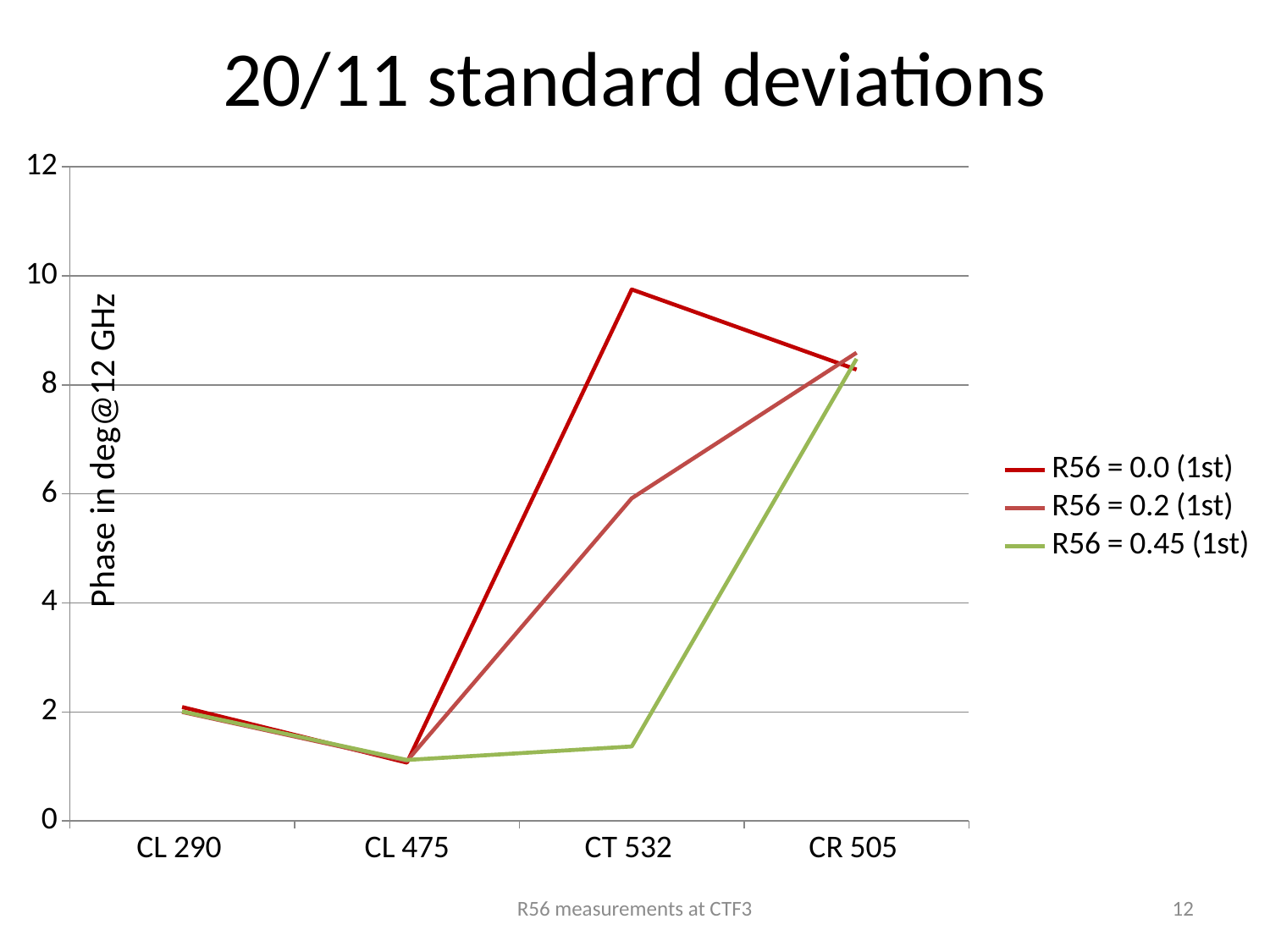
At CT 532, which series has the larger value, R56 = 0.0 (1st) or R56 = 0.45 (1st)? R56 = 0.0 (1st) Is the value for R56 = 0.2 (1st) at CL 475 greater or less than 2? less For the R56 = 0.0 (1st) series, which category has the lowest value? CL 475 For the R56 = 0.45 (1st) series, which category has the highest value? CR 505 How many categories are shown on the x axis? 4 How many series does the legend list? 3 Is the value for R56 = 0.0 (1st) at CT 532 greater or less than 8? greater What is the title of the y axis? Phase in deg@12 GHz Is the value for R56 = 0.45 (1st) at CT 532 greater or less than 2? less For the R56 = 0.0 (1st) series, which category has the highest value? CT 532 What kind of chart is shown on the slide? line chart